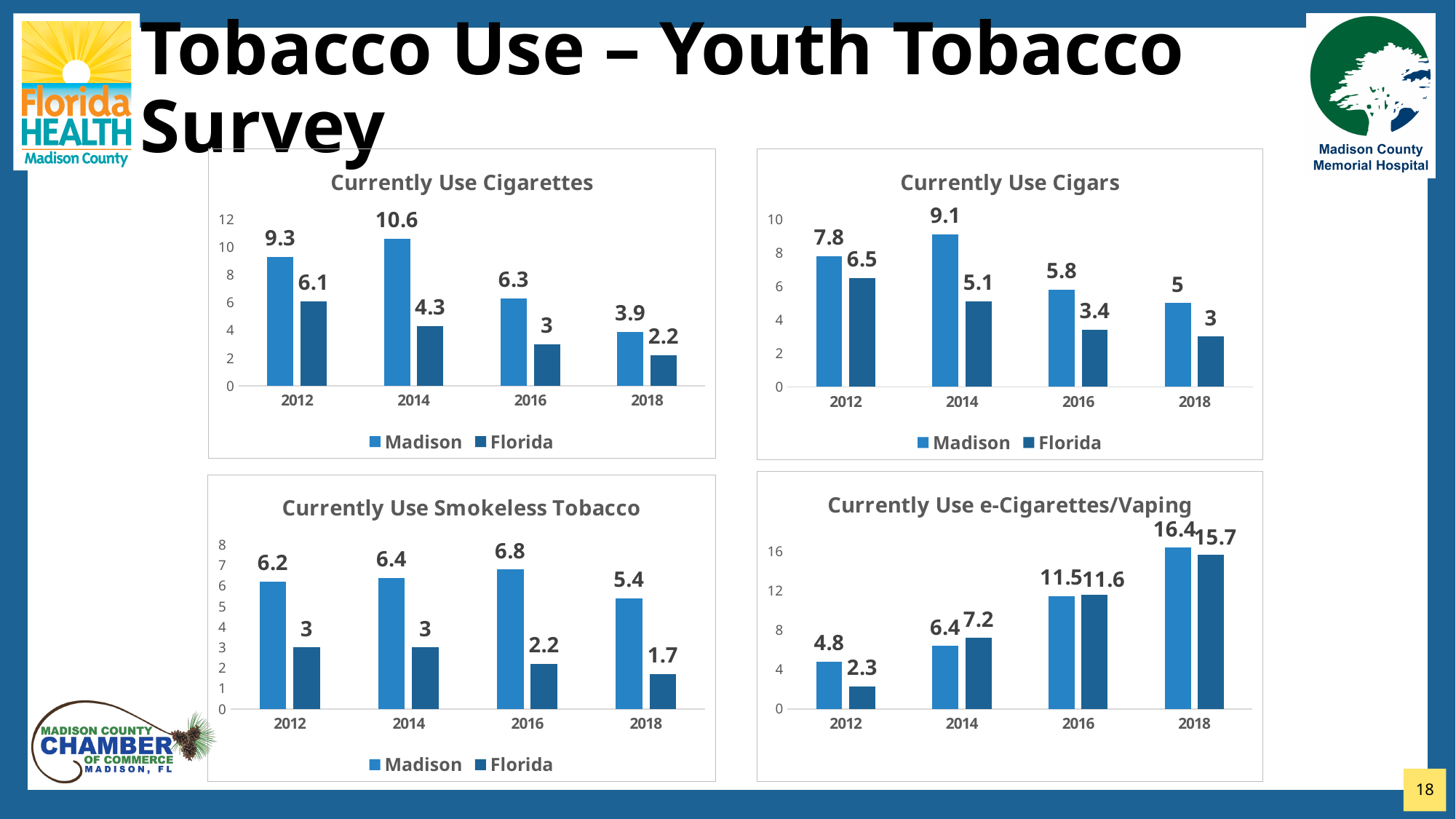
In the 'Currently Use Smokeless Tobacco' chart, which year has the lowest Florida value? 2018 What kind of chart is the 'Currently Use e-Cigarettes/Vaping' chart? bar chart In the 'Currently Use Smokeless Tobacco' chart, what is the Madison value for 2016? 6.8 In the 'Currently Use Cigarettes' chart, what is the Madison value for 2014? 10.6 In the 'Currently Use e-Cigarettes/Vaping' chart, which is larger for 2014, Madison or Florida? Florida How many years are shown on the x axis of the 'Currently Use Smokeless Tobacco' chart? 4 In the 'Currently Use Cigarettes' chart, do the Florida values rise or fall from 2012 to 2018? fall In the 'Currently Use Cigars' chart, which year has the highest Madison value? 2014 In the 'Currently Use Cigarettes' chart, what is the Florida value for 2018? 2.2 How many series does the legend of the 'Currently Use Cigars' chart list? 2 In the 'Currently Use Cigars' chart, what is the difference between the Madison and Florida values for 2012? 1.3 In the 'Currently Use e-Cigarettes/Vaping' chart, do the Madison values rise or fall from 2012 to 2018? rise